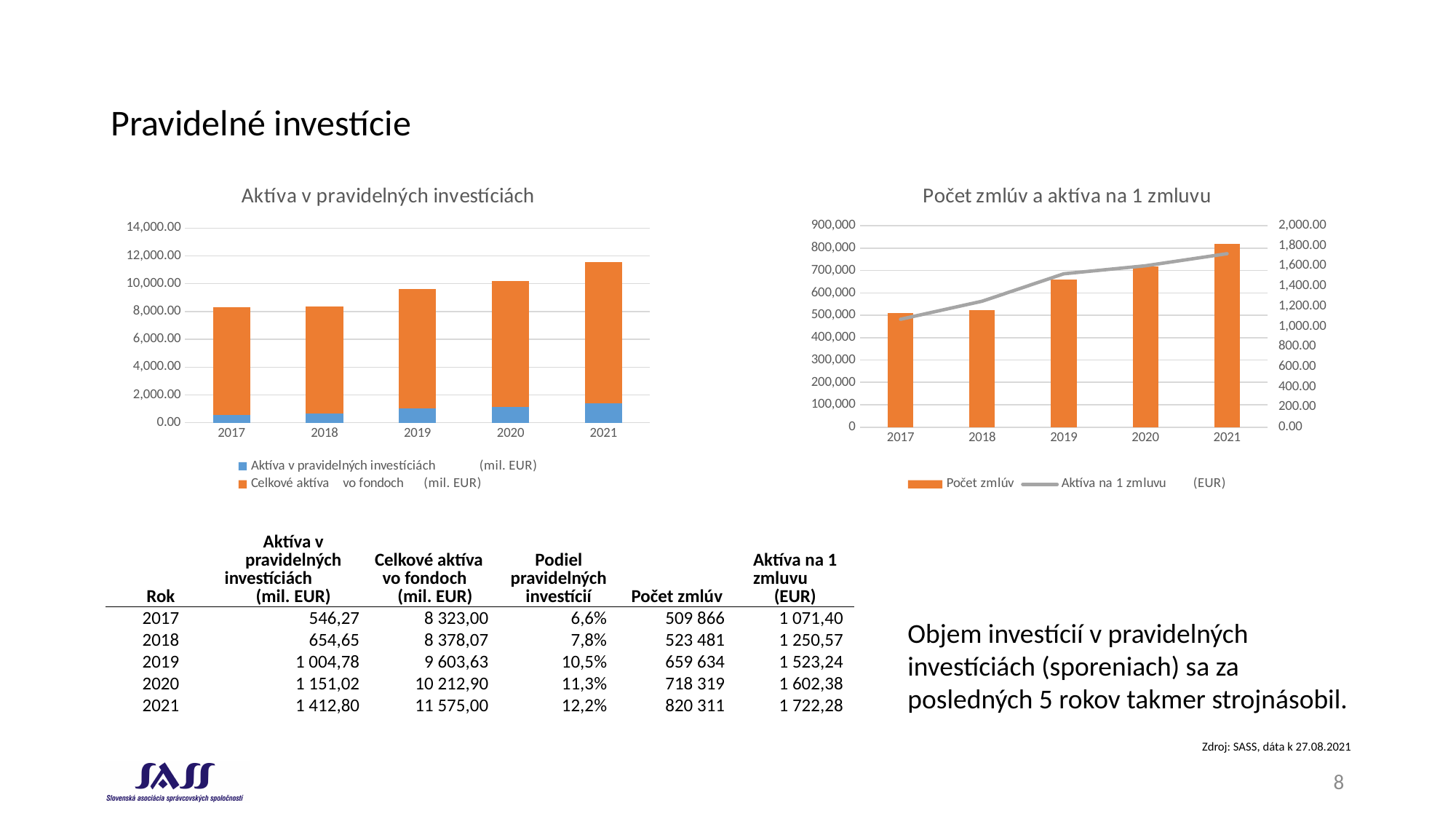
In the right chart "Počet zmlúv a aktíva na 1 zmluvu", how many series does the legend list? 2 In the right chart "Počet zmlúv a aktíva na 1 zmluvu", which series is drawn as a line? Aktíva na 1 zmluvu (EUR) In the left chart "Aktíva v pravidelných investíciách", which year has the highest value for Celkové aktíva vo fondoch? 2021 In the right chart "Počet zmlúv a aktíva na 1 zmluvu", which year has the lowest value for Počet zmlúv? 2017 In the left chart "Aktíva v pravidelných investíciách", is the value for Celkové aktíva vo fondoch in 2021 greater or less than 10,000.00? greater In the right chart "Počet zmlúv a aktíva na 1 zmluvu", is the value for Počet zmlúv in 2019 greater or less than 600,000? greater In the left chart "Aktíva v pravidelných investíciách", how many years are shown on the x axis? 5 In the left chart "Aktíva v pravidelných investíciách", do the values for Celkové aktíva vo fondoch rise or fall from 2017 to 2021? rise In the right chart "Počet zmlúv a aktíva na 1 zmluvu", is the value for Aktíva na 1 zmluvu in 2017 greater or less than 1,200.00? less In the left chart "Aktíva v pravidelných investíciách", how many series does the legend list? 2 What kind of chart is the left chart titled "Aktíva v pravidelných investíciách"? bar chart In the right chart "Počet zmlúv a aktíva na 1 zmluvu", is the value for Počet zmlúv in 2020 larger or smaller than in 2021? smaller